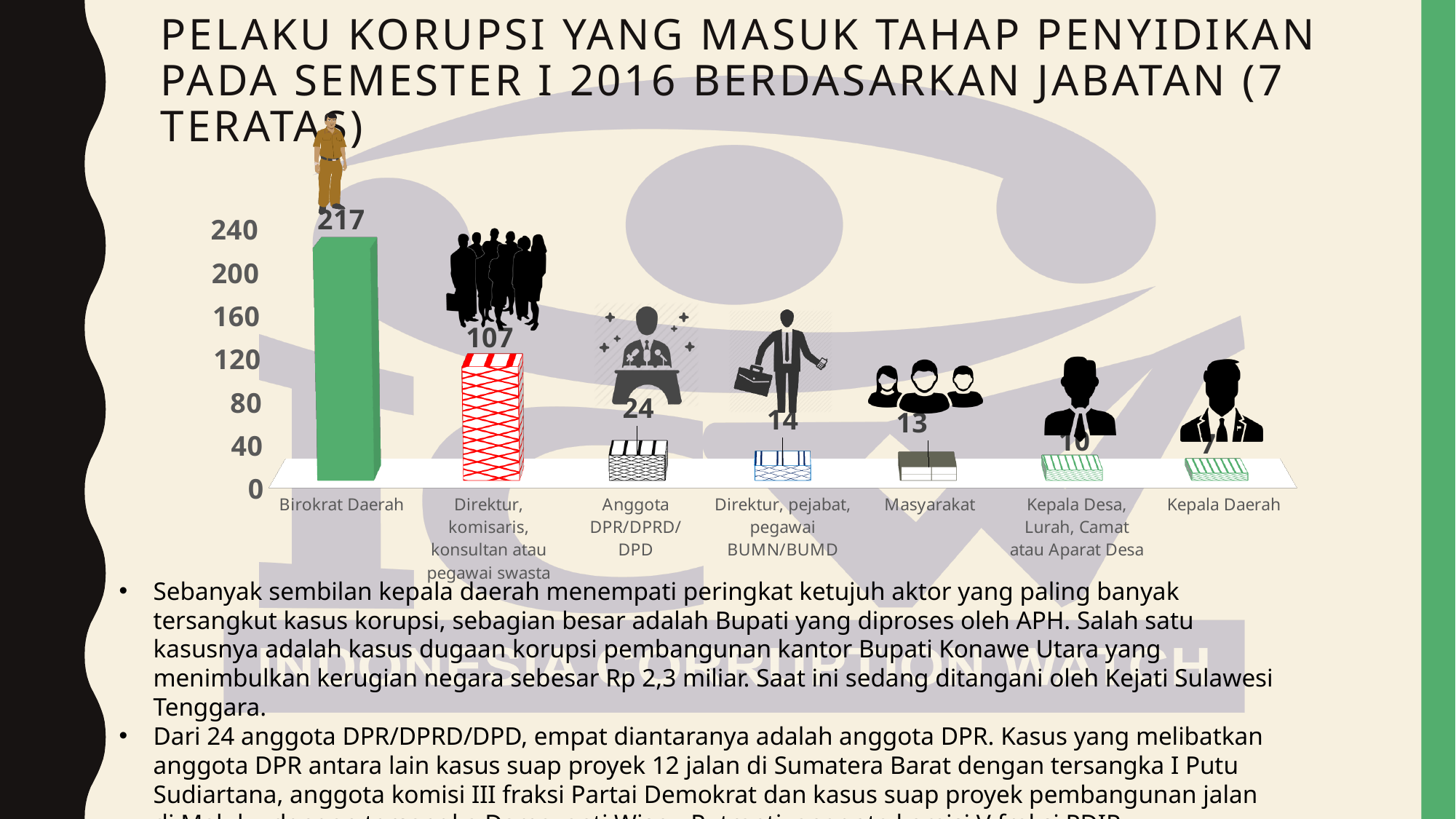
How many categories are shown on the chart? 7 Is the value for Kepala Desa, Lurah, Camat atau Aparat Desa greater or less than 40? less What is the value for Direktur, pejabat, pegawai BUMN/BUMD? 14 What is the value for Anggota DPR/DPRD/DPD? 24 What kind of chart is shown on the slide? bar chart Which category has the lowest value? Kepala Daerah Which is larger, the value for Anggota DPR/DPRD/DPD or the value for Masyarakat? Anggota DPR/DPRD/DPD What is the value for Birokrat Daerah? 217 What is the value for Direktur, komisaris, konsultan atau pegawai swasta? 107 Which category has the highest value? Birokrat Daerah What is the value for Masyarakat? 13 What is the difference between the values for Birokrat Daerah and Direktur, komisaris, konsultan atau pegawai swasta? 110